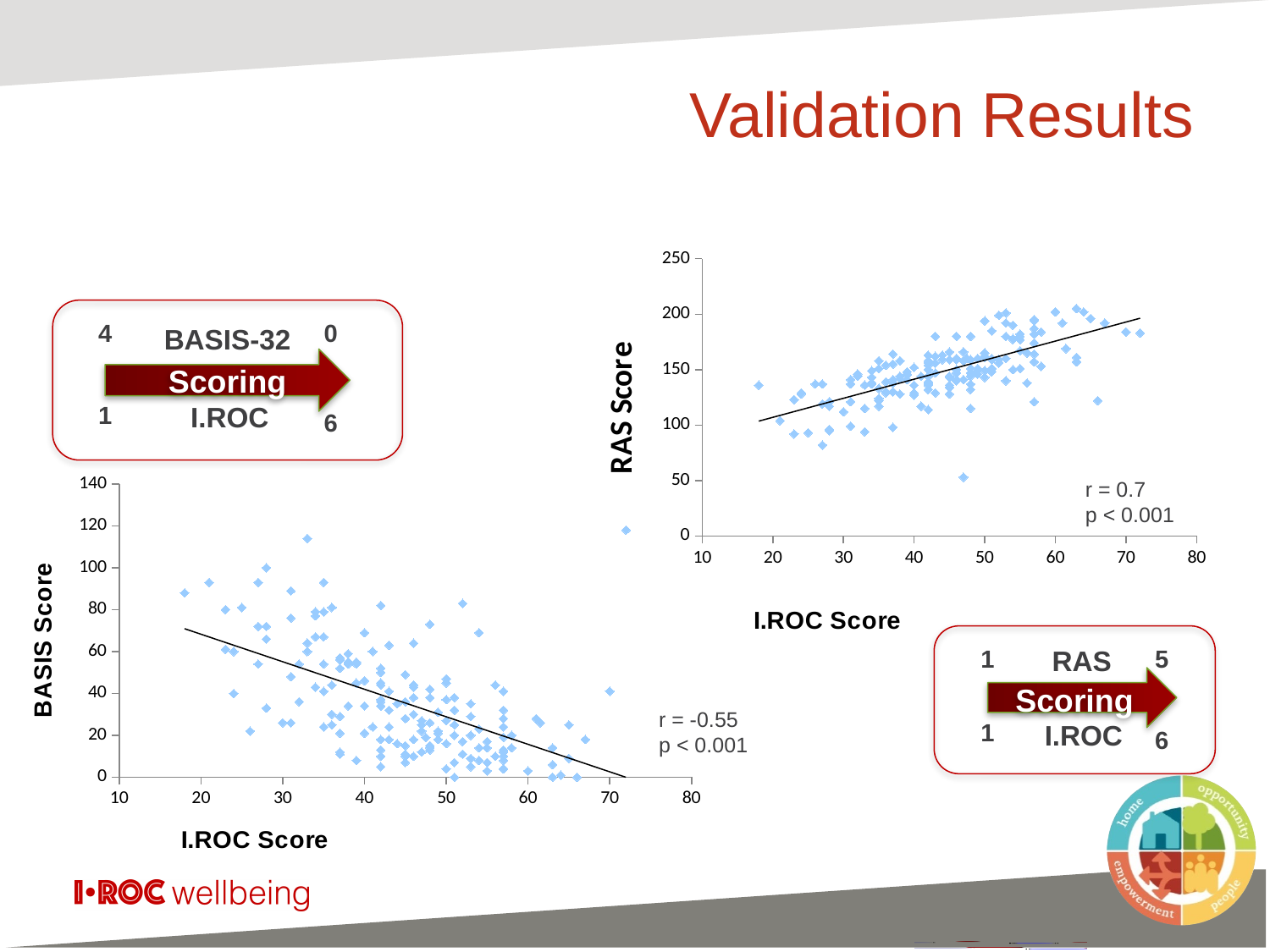
What is the highest value shown on the y axis of the bottom-left chart (BASIS Score)? 140 What is the x-axis label of the bottom-left chart? I.ROC Score What kind of chart is the top-right chart with RAS Score on the y axis? scatter chart In the bottom-left chart (BASIS Score vs I.ROC Score), do the values rise or fall as I.ROC Score increases? fall What kind of chart is the bottom-left chart with BASIS Score on the y axis? scatter chart What is the highest value shown on the y axis of the top-right chart (RAS Score)? 250 In the top-right chart (RAS Score vs I.ROC Score), do the values rise or fall as I.ROC Score increases? rise How many scatter charts are shown on the slide? 2